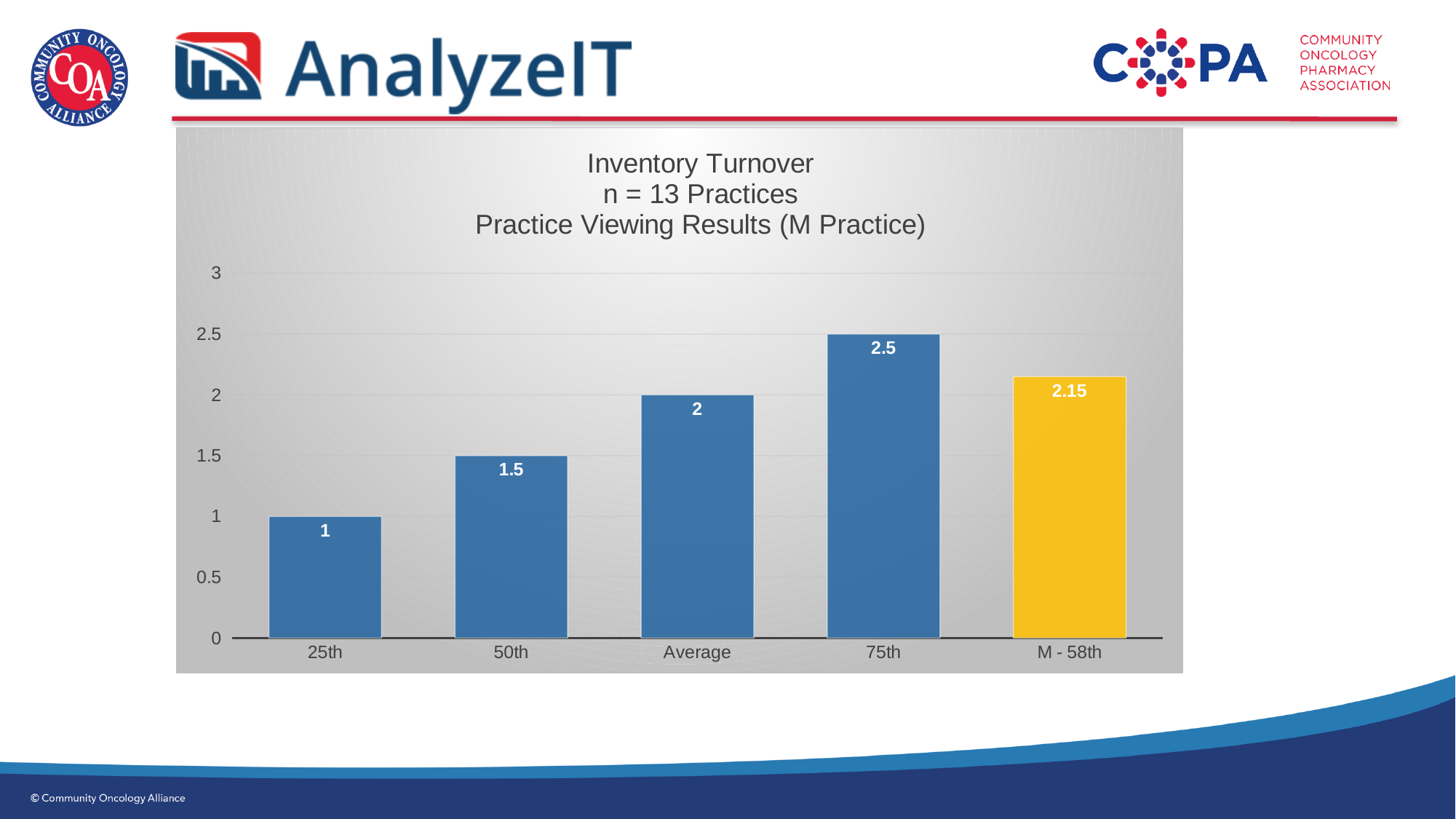
What is the value for the 25th category? 1 What is the value for the 75th category? 2.5 What is the value for the 50th category? 1.5 How many practices does the chart title say are included (n)? 13 How many categories are shown on the x axis? 5 What is the difference between the 75th value and the M - 58th value? 0.35 What is the value for M - 58th? 2.15 Which category has the highest value? 75th What is the value for Average? 2 Which is larger, the value for Average or the value for M - 58th? M - 58th What kind of chart is this? Bar chart Which category has the lowest value? 25th